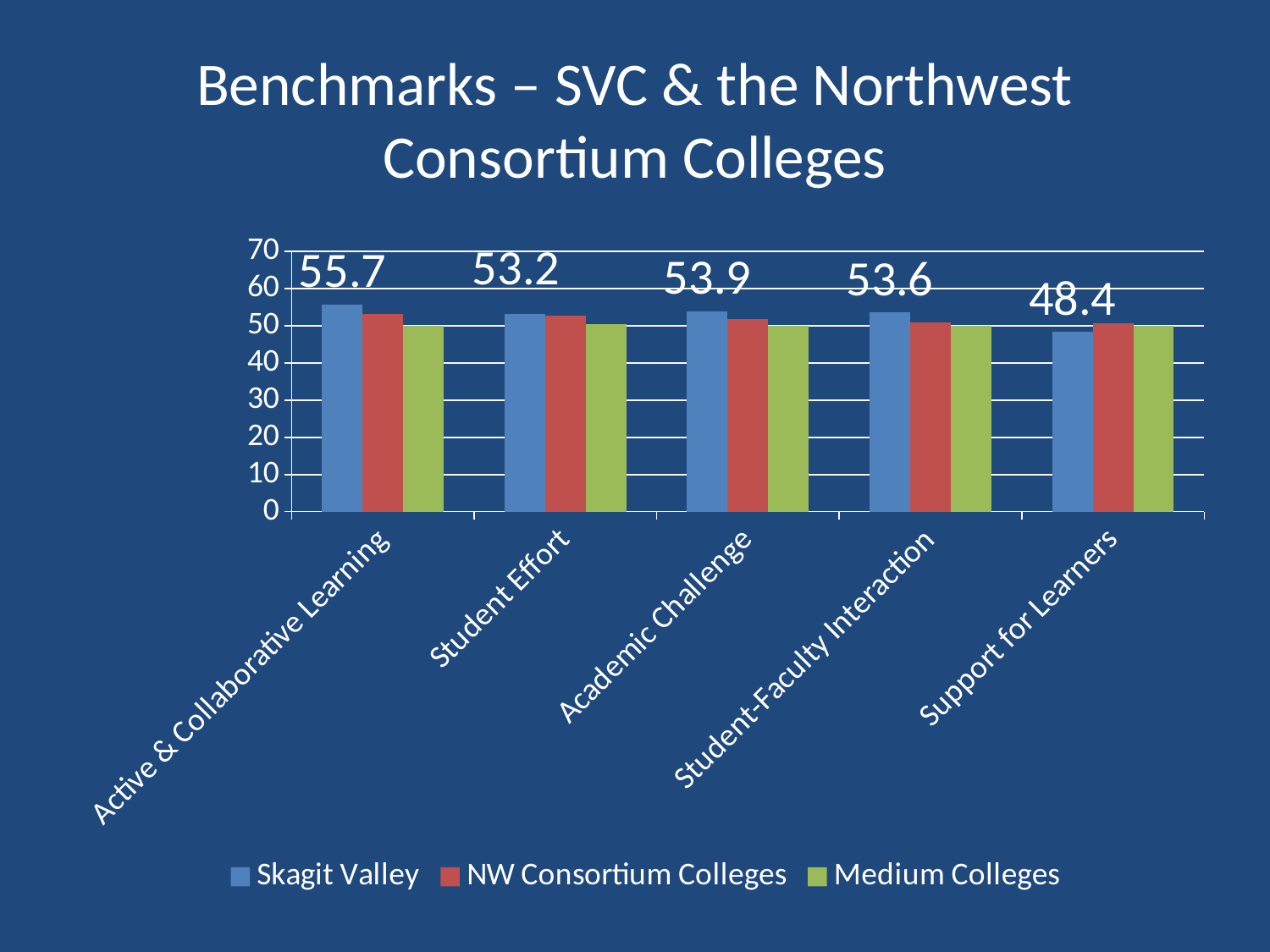
Is the Medium Colleges value for Student Effort greater or less than 60? less Which benchmark has the lowest Skagit Valley value? Support for Learners What is the Skagit Valley value for Support for Learners? 48.4 Which has the larger Skagit Valley value, Academic Challenge or Student-Faculty Interaction? Academic Challenge What is the Skagit Valley value for Academic Challenge? 53.9 What is the difference between the Skagit Valley values for Active & Collaborative Learning and Support for Learners? 7.3 How many benchmark categories are shown on the x axis? 5 What is the Skagit Valley value for Student Effort? 53.2 How many series does the legend list? 3 What kind of chart is shown on the slide? bar chart What is the Skagit Valley value for Active & Collaborative Learning? 55.7 Which benchmark has the highest Skagit Valley value? Active & Collaborative Learning